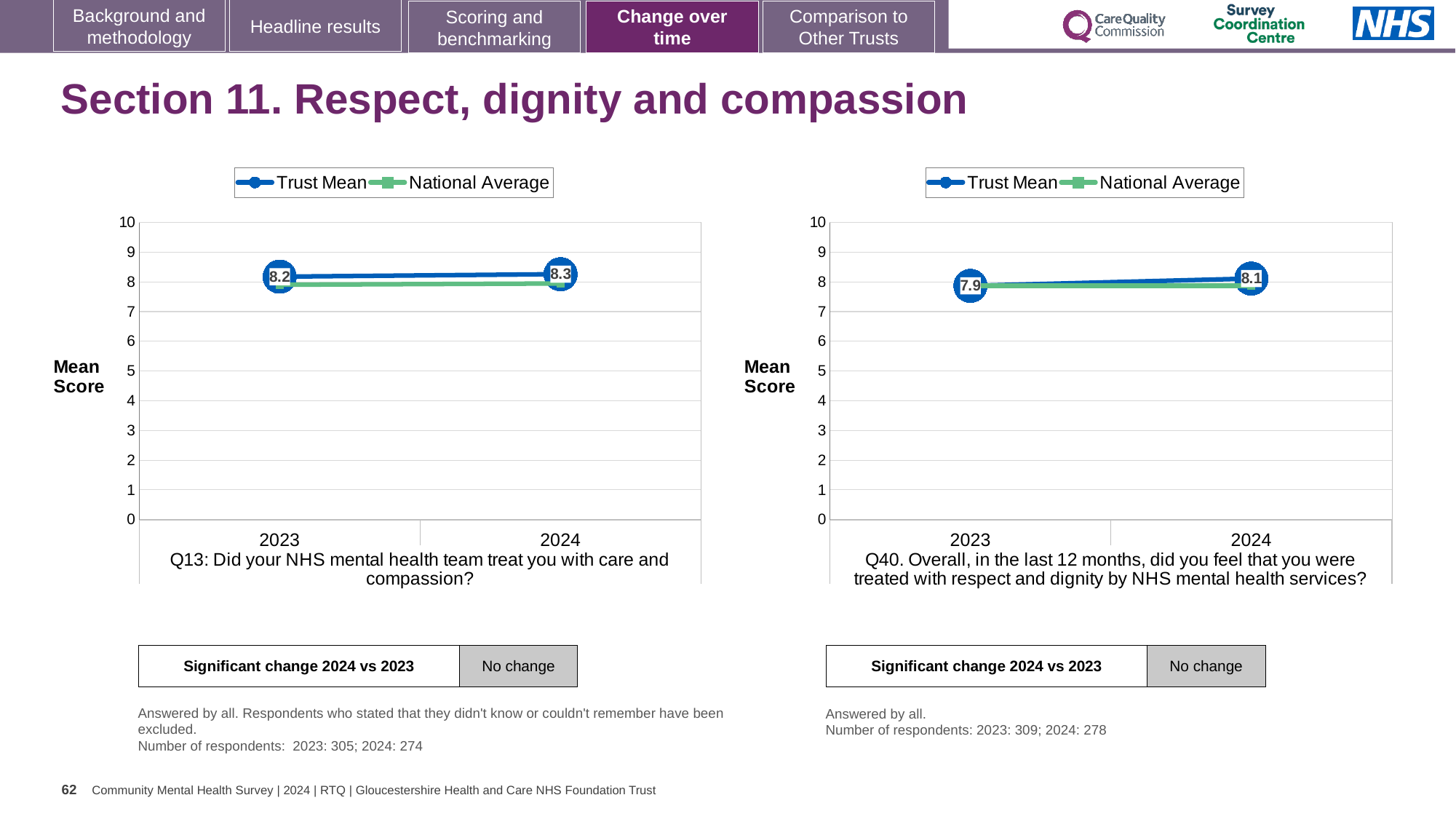
In the left chart (Q13), is the National Average for 2024 greater or less than 9? less In the right chart (Q40), is the National Average for 2023 greater or less than 5? greater In the left chart (Q13), what is the Trust Mean for 2024? 8.3 In the right chart (Q40), what is the Trust Mean for 2024? 8.1 How many years are plotted on the x axis of the left chart (Q13)? 2 In the left chart (Q13), what is the Trust Mean for 2023? 8.2 What kind of chart is the left chart (Q13)? line chart How many series does the legend of the right chart (Q40) list? 2 In the right chart (Q40), does the Trust Mean rise or fall from 2023 to 2024? rise In the right chart (Q40), by how much did the Trust Mean change from 2023 to 2024? 0.2 In the right chart (Q40), what is the Trust Mean for 2023? 7.9 In the left chart (Q13), what is the difference between the Trust Mean in 2024 and in 2023? 0.1